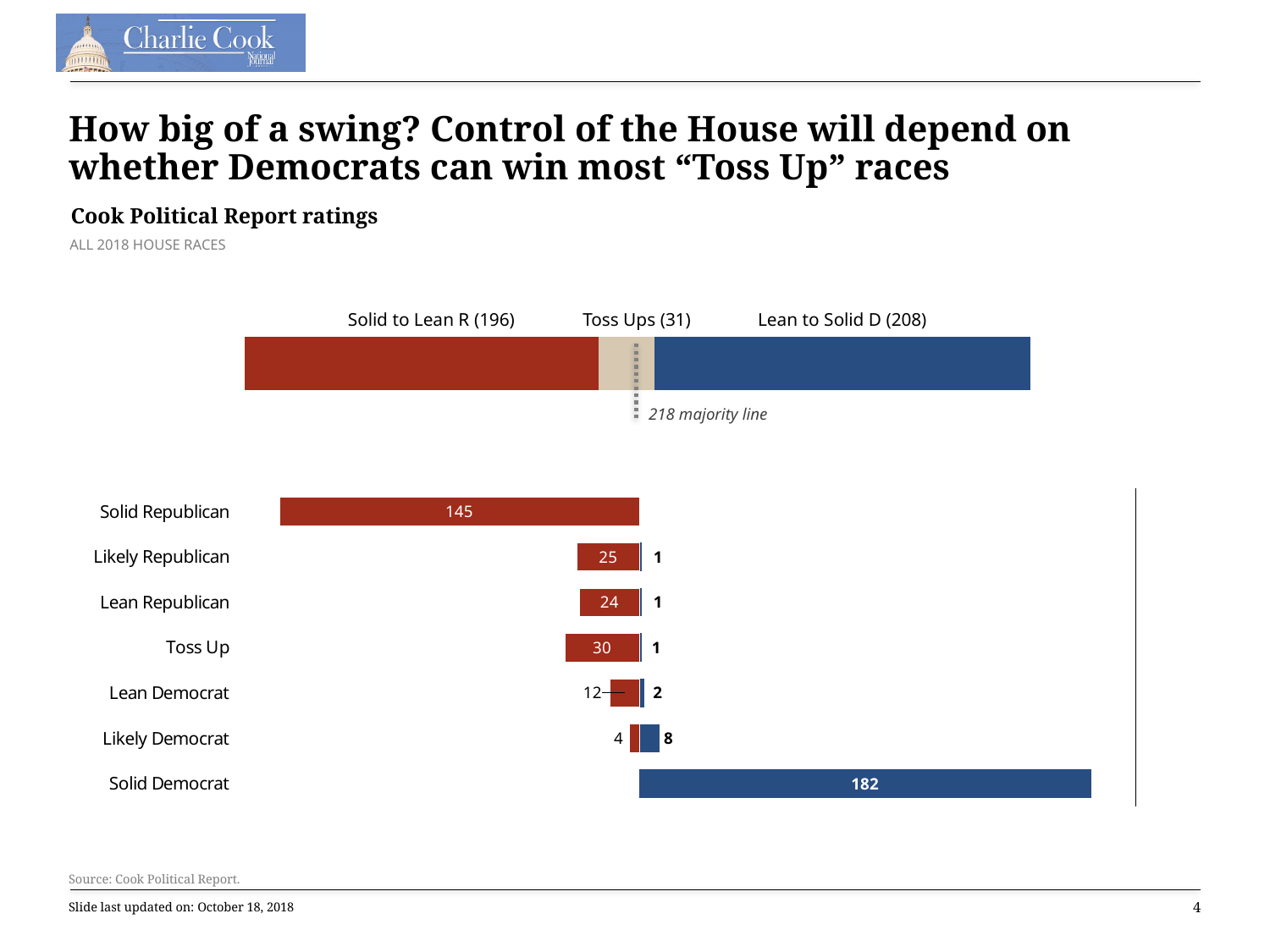
In the top stacked bar chart, what is the value for Solid to Lean R? 196 In the bottom bar chart, what is the red bar value for Toss Up? 30 In the bottom bar chart, which category has the largest red bar? Solid Republican In the top stacked bar chart, what majority line is marked? 218 majority line In the bottom bar chart, what is the difference between the Solid Democrat blue bar and the Solid Republican red bar? 37 In the bottom bar chart, what is the blue bar value for Likely Democrat? 8 In the top stacked bar chart, what is the value for Toss Ups? 31 In the bottom bar chart, what is the blue bar value for Solid Democrat? 182 In the bottom bar chart, what is the red bar value for Solid Republican? 145 In the top stacked bar chart, what is the value for Lean to Solid D? 208 In the bottom bar chart, how many categories are listed? 7 In the top stacked bar chart, what is the total of the three segments? 435